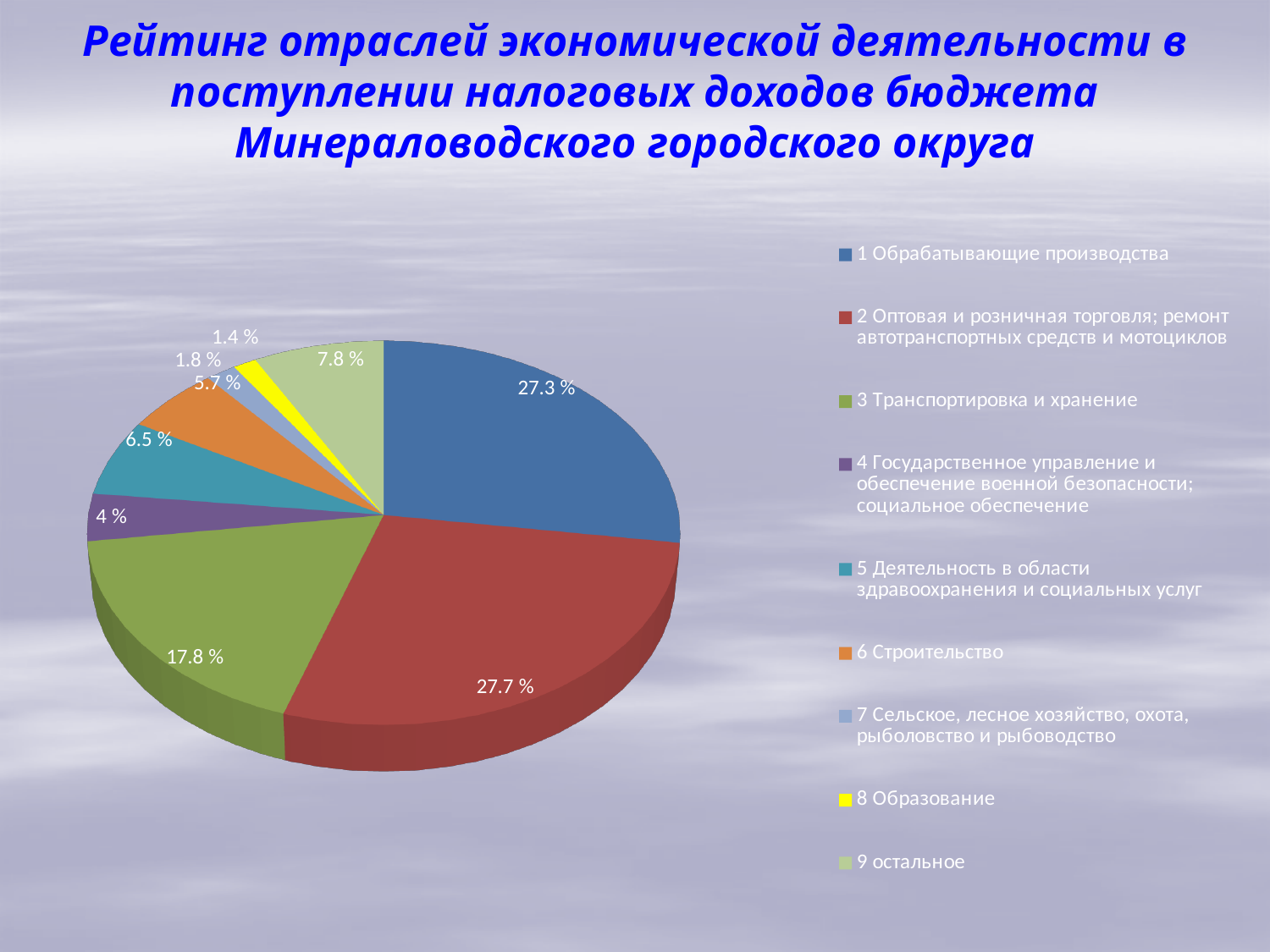
What kind of chart is shown on the slide? pie chart How many sectors (slices) does the pie chart show? 9 What share is shown for Образование? 1.4 % What is the difference between the shares of Оптовая и розничная торговля and Обрабатывающие производства? 0.4 % What share of tax revenue comes from Обрабатывающие производства? 27.3 % What colour is the slice for Образование? yellow Which sector has the smallest share of the pie? 8 Образование Which sector has the largest share of the pie? 2 Оптовая и розничная торговля; ремонт автотранспортных средств и мотоциклов Which is larger: the share for Строительство or the share for Государственное управление? Строительство What share is shown for Строительство? 5.7 % What share is shown for Деятельность в области здравоохранения и социальных услуг? 6.5 % What share is shown for Транспортировка и хранение? 17.8 %